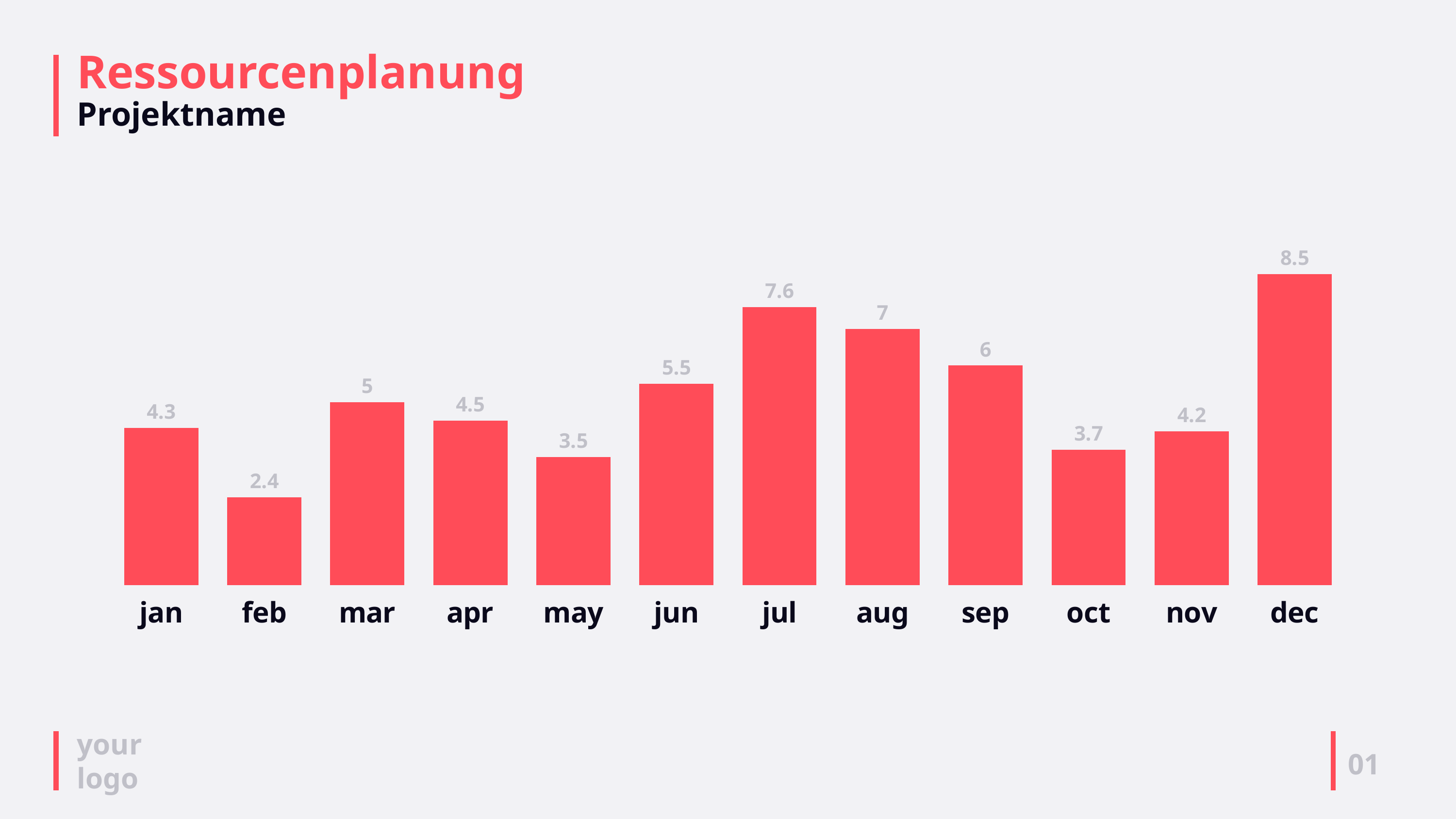
What is the value for jul? 7.6 What is the difference between the values for dec and jul? 0.9 Which is larger, the value for aug or the value for sep? aug What is the value for oct? 3.7 Do the values rise or fall from may to jul? rise Which month has the lowest value? feb What is the value for feb? 2.4 How many months are shown on the x axis? 12 What is the difference between the values for mar and feb? 2.6 Which month has the highest value? dec Which is larger, the value for jan or the value for may? jan What kind of chart is shown on the slide? bar chart